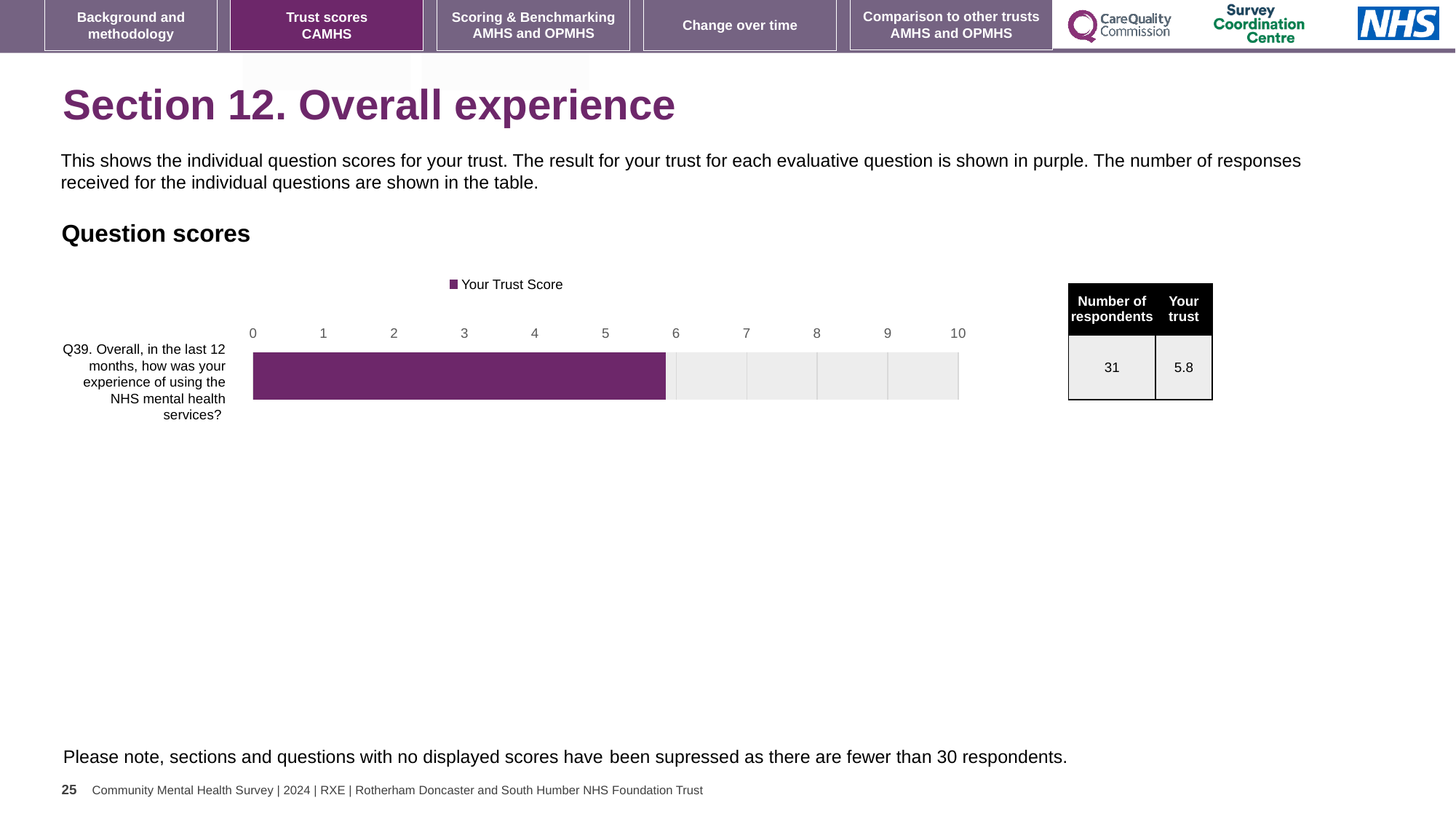
Is the bar for Q39 in the Question scores chart greater or less than 6? less What is the trust score for Q39 (Overall, in the last 12 months, how was your experience of using the NHS mental health services?) as shown in the table? 5.8 What kind of chart is shown under "Question scores"? bar chart How many questions (bars) are plotted in the Question scores chart? 1 What is the name of the series shown in the legend of the Question scores chart? Your Trust Score How many series does the legend of the Question scores chart list? 1 How many respondents answered Q39 according to the table next to the chart? 31 What is the maximum value shown on the x axis of the Question scores chart? 10 Is the bar for Q39 in the Question scores chart greater or less than 5? greater Is the bar for Q39 in the Question scores chart greater or less than 8? less